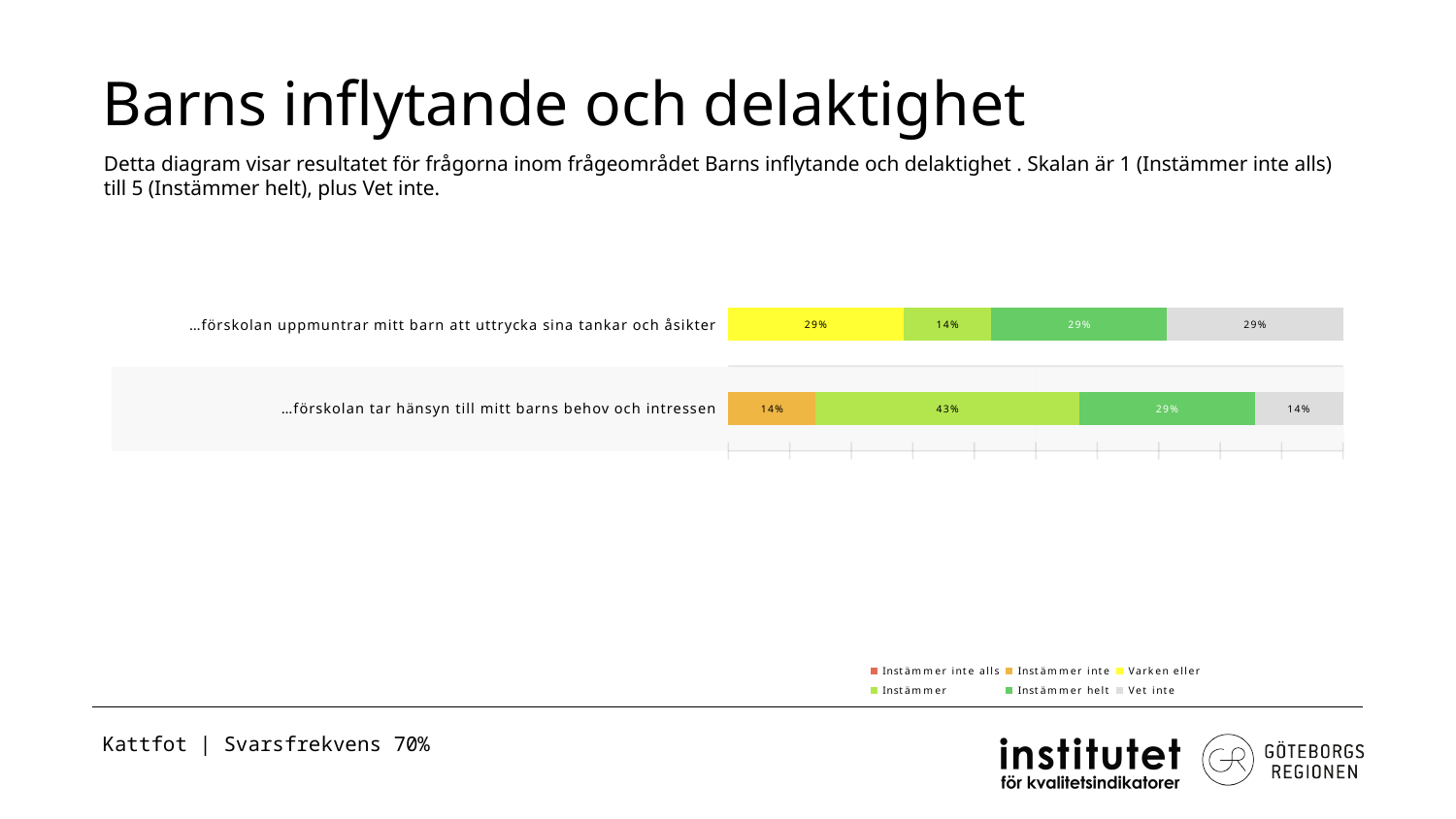
How many categories (questions) are plotted in the chart? 2 What is the 'Instämmer' value for '…förskolan uppmuntrar mitt barn att uttrycka sina tankar och åsikter'? 14% What is the 'Varken eller' value for '…förskolan uppmuntrar mitt barn att uttrycka sina tankar och åsikter'? 29% What is the 'Instämmer helt' value for '…förskolan tar hänsyn till mitt barns behov och intressen'? 29% What is the 'Instämmer' value for '…förskolan tar hänsyn till mitt barns behov och intressen'? 43% What is the 'Vet inte' value for '…förskolan tar hänsyn till mitt barns behov och intressen'? 14% What is the difference between the 'Instämmer' values of '…förskolan tar hänsyn till mitt barns behov och intressen' and '…förskolan uppmuntrar mitt barn att uttrycka sina tankar och åsikter'? 29% What is the 'Instämmer inte' value for '…förskolan tar hänsyn till mitt barns behov och intressen'? 14% Which legend entry is shown in grey? Vet inte What kind of chart is shown on the slide? stacked bar chart Which category has the larger 'Instämmer' value: '…förskolan uppmuntrar mitt barn att uttrycka sina tankar och åsikter' or '…förskolan tar hänsyn till mitt barns behov och intressen'? …förskolan tar hänsyn till mitt barns behov och intressen How many series does the legend list? 6